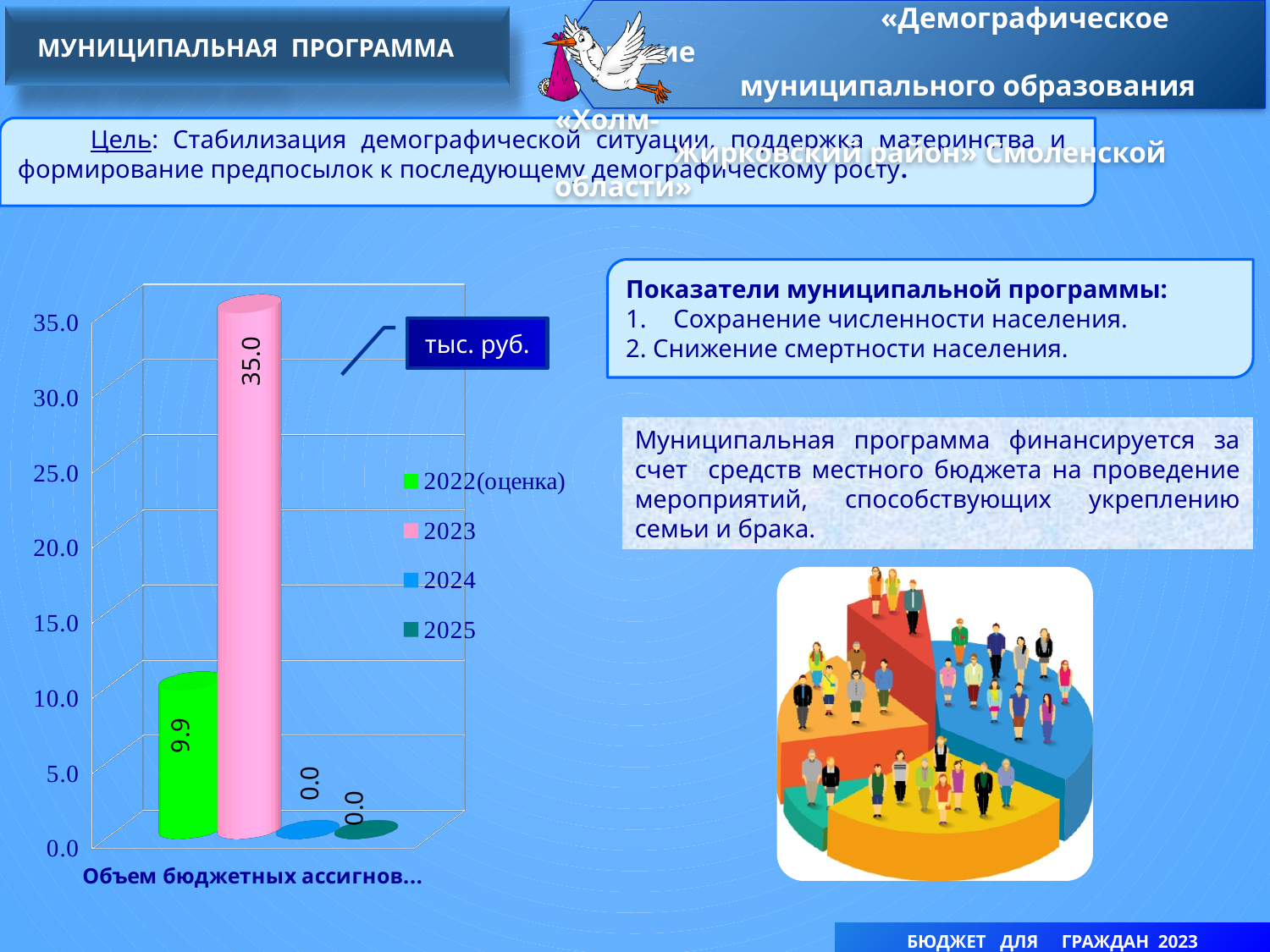
What unit of measurement is indicated in the callout next to the chart? тыс. руб. How many series does the chart legend list? 4 What is the value for 2025 in the chart? 0.0 What is the value for 2024 in the chart? 0.0 Which is larger, the value for 2022(оценка) or the value for 2023? 2023 What is the value for 2022(оценка) in the chart? 9.9 What is the difference between the values for 2023 and 2022(оценка)? 25.1 What colour is the bar for 2023 in the chart? pink Which year has the highest value in the chart? 2023 Is the value for 2022(оценка) greater or less than 10.0? less What is the value for 2023 in the chart? 35.0 What kind of chart is shown on the slide? bar chart